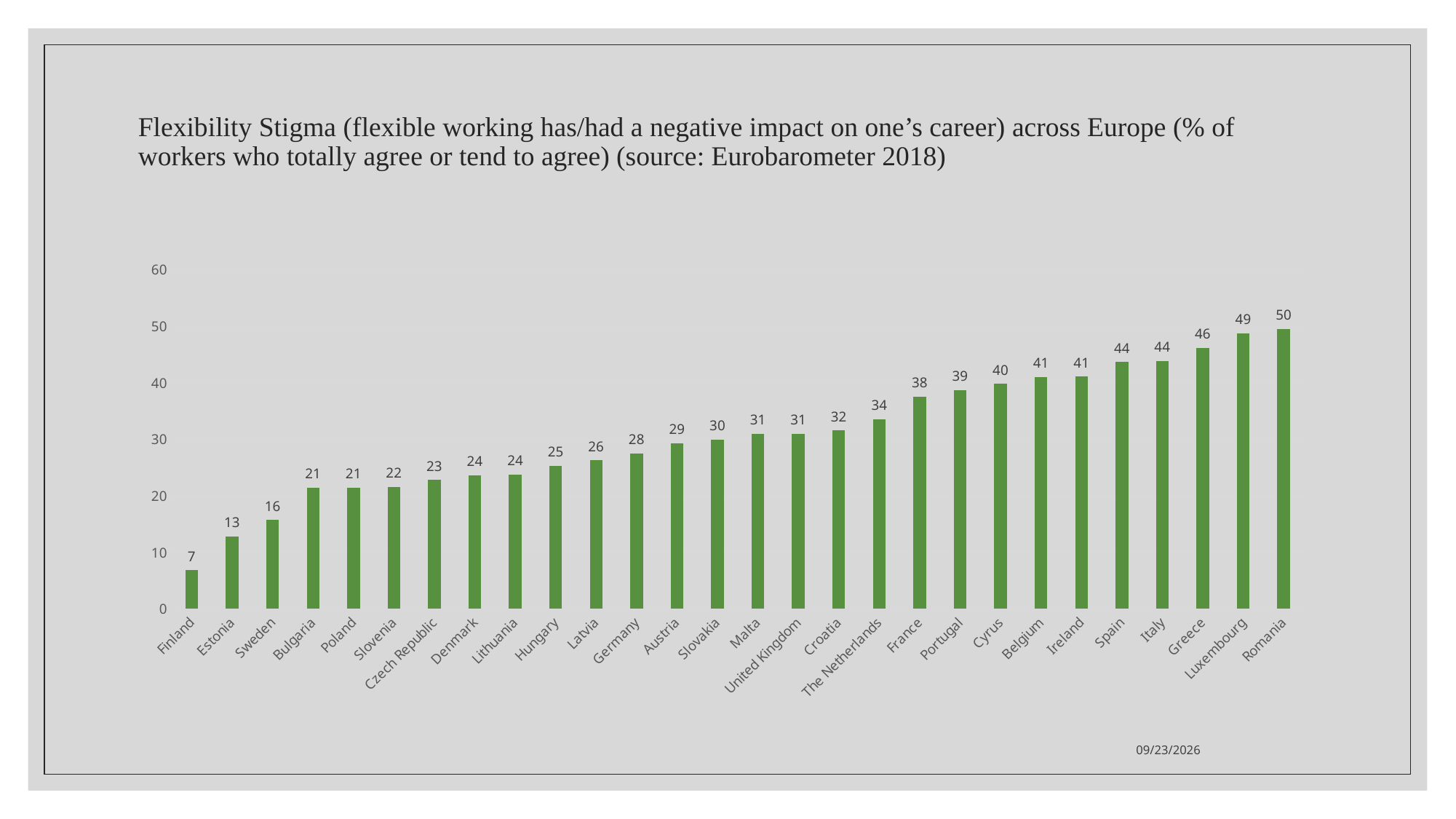
What is the difference between the values for France and Denmark? 14 Which has a larger value, Greece or Portugal? Greece What kind of chart is shown on the slide? Bar chart Which country has the lowest value? Finland How many countries are shown in the chart? 28 What is the value for Luxembourg? 49 What is the value for Finland? 7 What is the value for The Netherlands? 34 Do the values rise or fall from left to right along the x axis? Rise What is the difference between the values for Romania and Finland? 43 What is the value for Germany? 28 Which country has the highest value? Romania